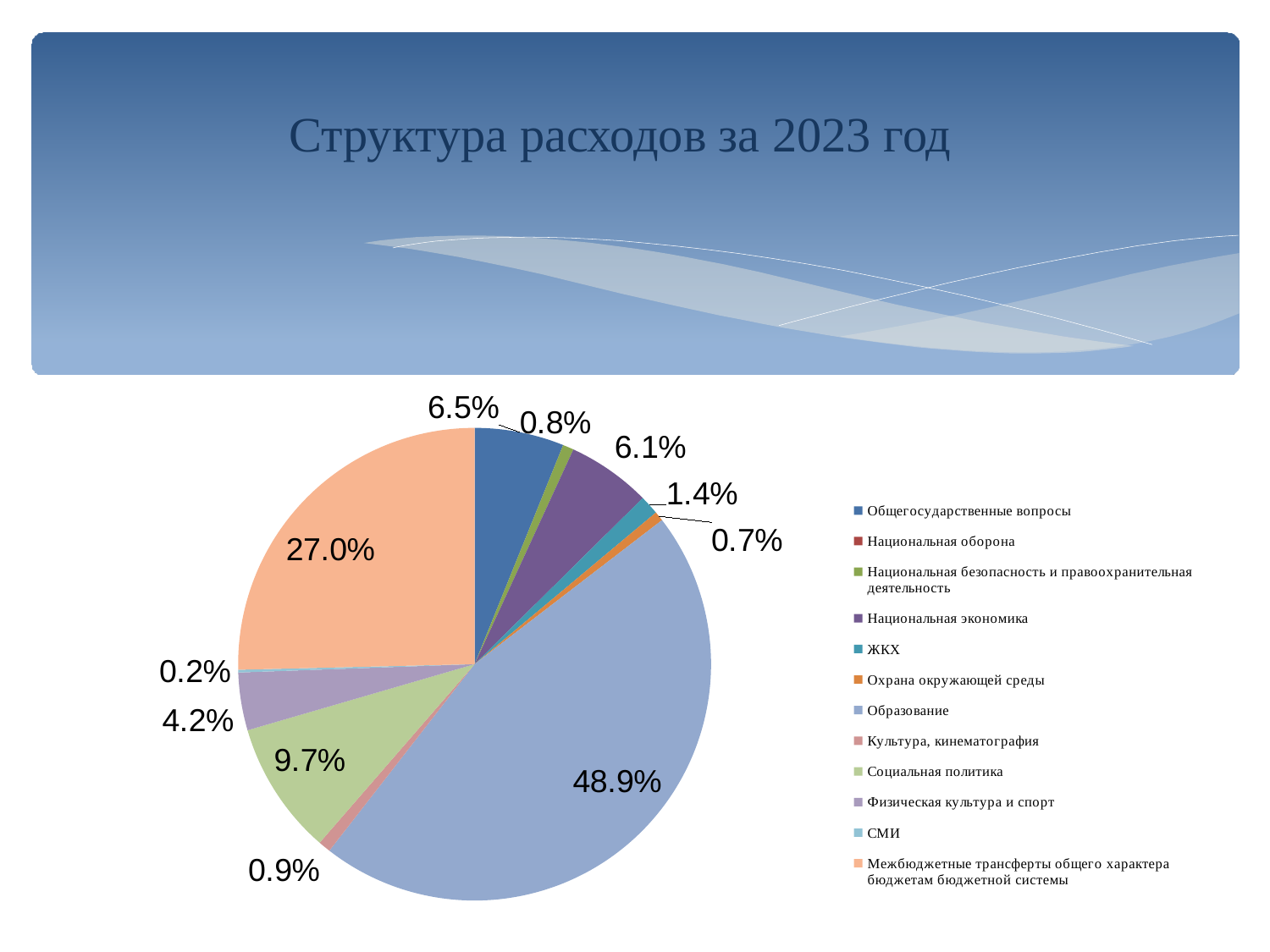
What is the difference between the shares of Образование and Межбюджетные трансферты общего характера бюджетам бюджетной системы? 21.9% What is the value shown for Межбюджетные трансферты общего характера бюджетам бюджетной системы? 27.0% What share of expenditures does Образование account for? 48.9% What percentage is shown for ЖКХ? 1.4% What is the title of the chart on the slide? Структура расходов за 2023 год What type of chart is shown on the slide? pie chart Which is larger: the share for Общегосударственные вопросы or for Национальная экономика? Общегосударственные вопросы What is the value for Национальная экономика? 6.1% Which category has the largest slice of the pie? Образование Which labeled category has the smallest slice of the pie? СМИ What percentage is shown for Социальная политика? 9.7% How many categories are listed in the legend? 12